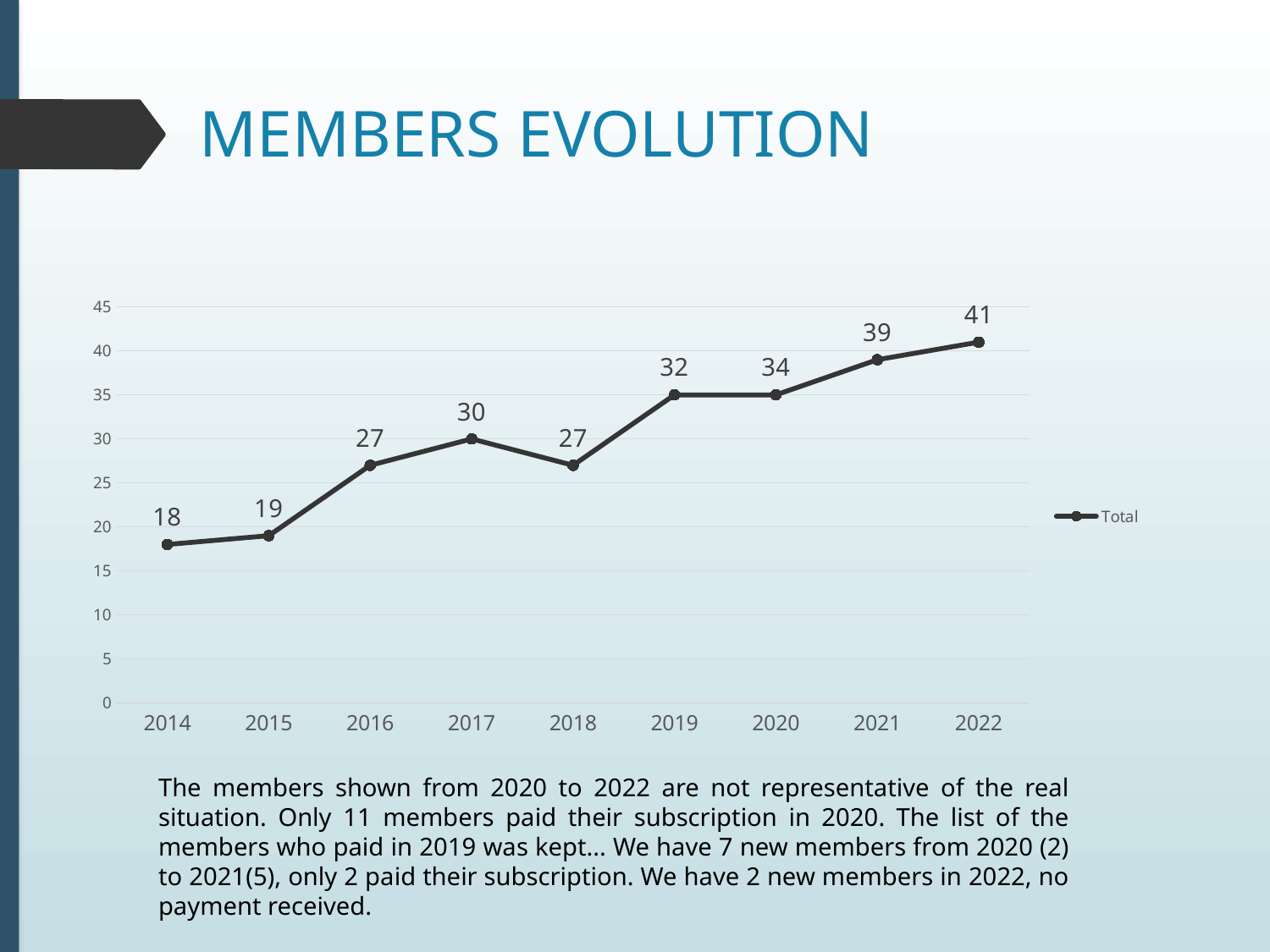
What is the value for 2021? 39 Which year has the highest value? 2022 How many series does the legend list? 1 What is the difference between the values for 2022 and 2014? 23 What is the value for 2014? 18 What type of chart is shown on the slide? Line chart Which year has the lowest value? 2014 What is the value for 2017? 30 What is the name of the series shown in the legend? Total Which is larger, the value for 2017 or the value for 2018? 2017 How many years are plotted on the x axis? 9 What is the value for 2022? 41